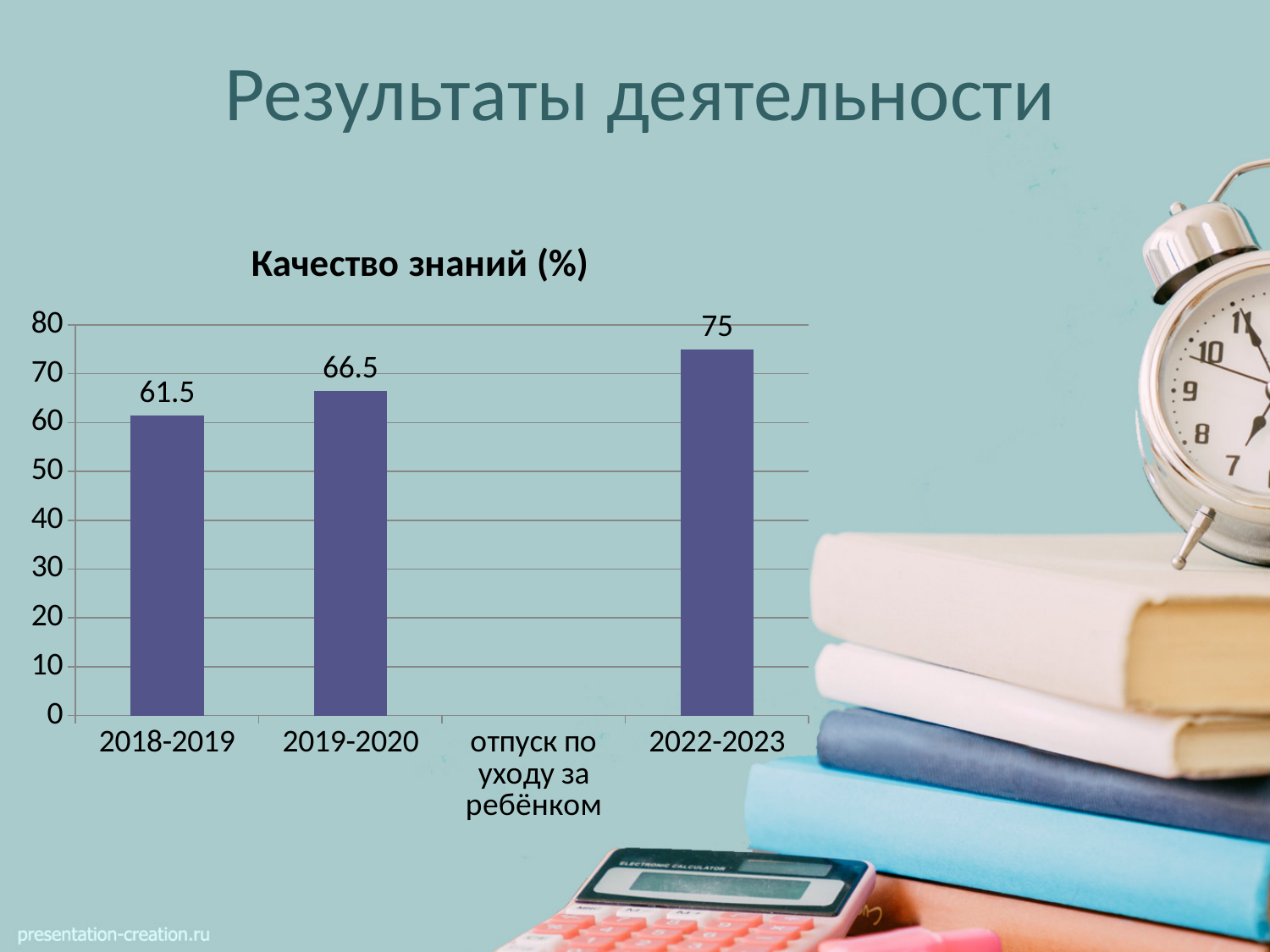
Do the plotted values rise or fall from 2018-2019 to 2022-2023? rise What is the value for 2019-2020 in the chart? 66.5 What is the difference between the values for 2019-2020 and 2018-2019? 5 How many categories are shown on the x axis of the chart? 4 What is the difference between the values for 2022-2023 and 2018-2019? 13.5 Which category has the highest value? 2022-2023 What is the value for 2018-2019 in the chart? 61.5 Which is larger, the value for 2019-2020 or the value for 2022-2023? 2022-2023 Which category with a plotted bar has the lowest value? 2018-2019 What is the value for 2022-2023 in the chart? 75 What kind of chart is shown on the slide? bar chart What is the title of the chart? Качество знаний (%)